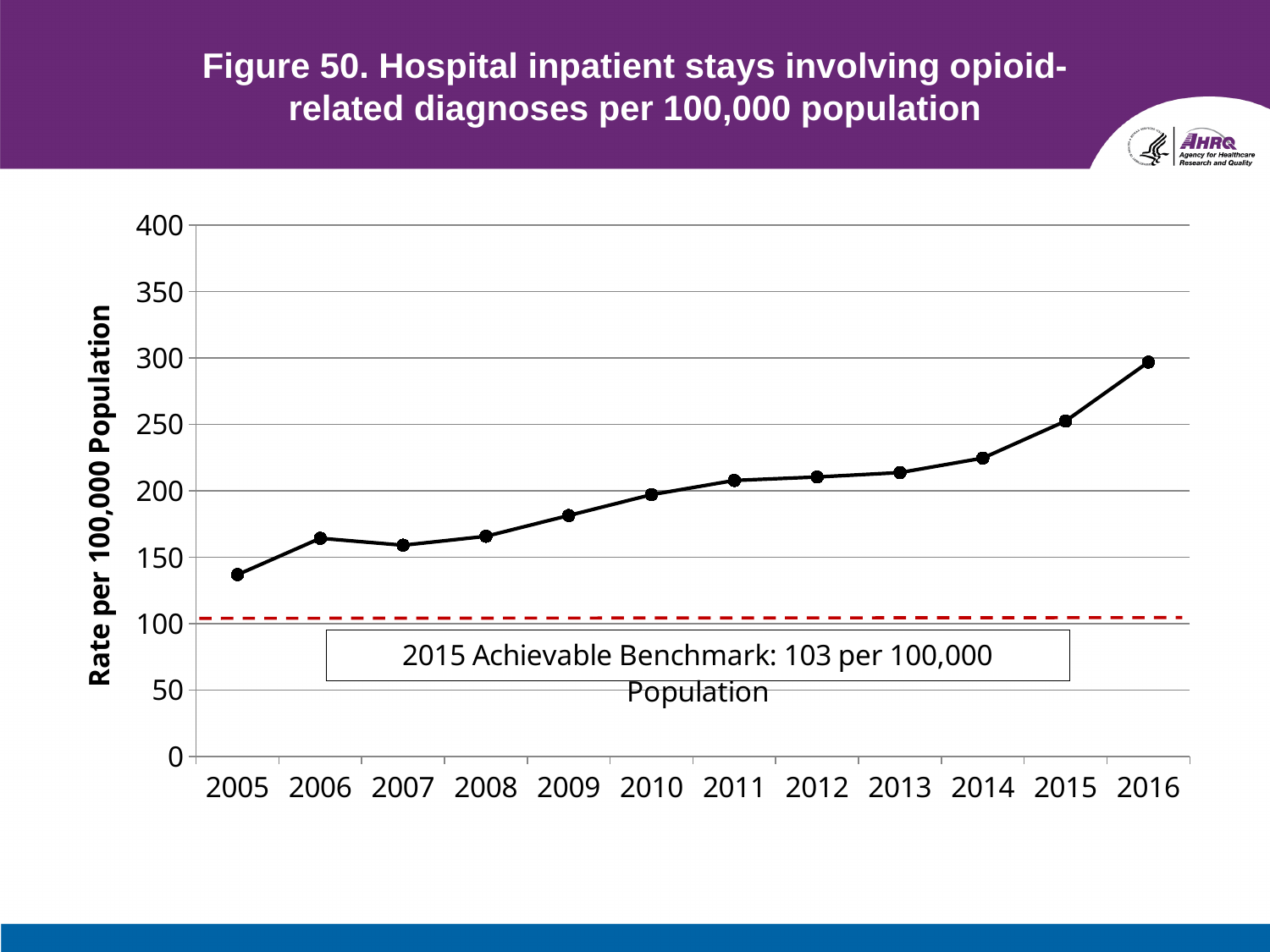
Which year has the highest rate of hospital inpatient stays involving opioid-related diagnoses? 2016 Which is larger, the value for 2006 or the value for 2005? 2006 Which year has the lowest rate of hospital inpatient stays involving opioid-related diagnoses? 2005 Is the value for 2009 greater or less than 200? less What is the 2015 achievable benchmark shown on the chart? 103 per 100,000 Population What is the title of the y axis? Rate per 100,000 Population What kind of chart is shown on the slide? line chart How many years are plotted along the x axis? 12 Is the value for 2016 greater or less than 250? greater Is the value for 2014 greater or less than 200? greater Overall, do the values rise or fall from 2005 to 2016? rise